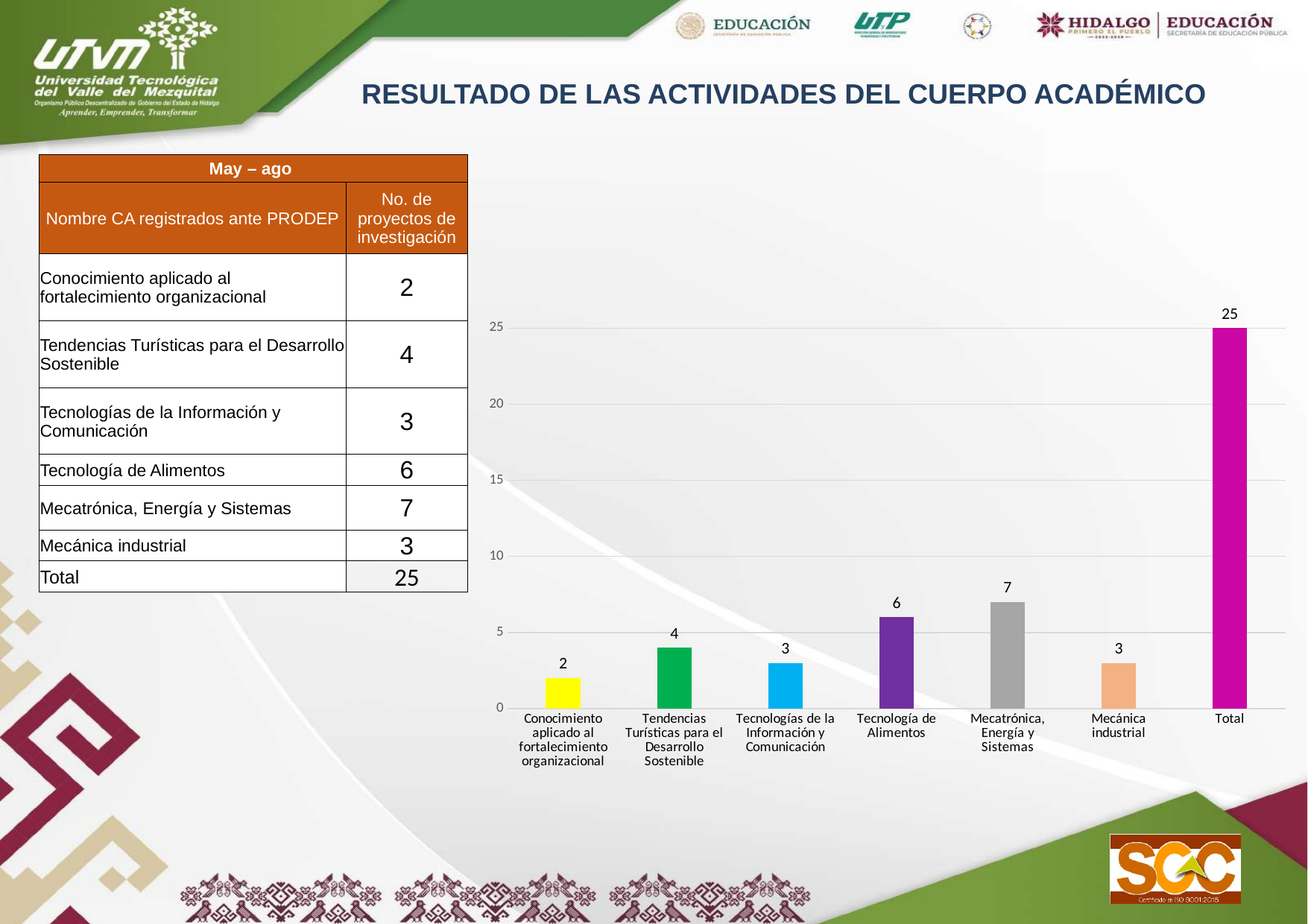
What colour is the Total bar in the chart? Magenta What type of chart is shown on the slide? Bar chart What is the difference between the values for Mecatrónica, Energía y Sistemas and Tendencias Turísticas para el Desarrollo Sostenible? 3 What is the value for Mecatrónica, Energía y Sistemas in the bar chart? 7 Excluding the Total bar, which category has the highest value in the chart? Mecatrónica, Energía y Sistemas What is the value of the Total bar in the chart? 25 Is the value for Tecnología de Alimentos greater or less than 5? greater Which category has the lowest value in the bar chart? Conocimiento aplicado al fortalecimiento organizacional Which is larger in the chart: Tecnología de Alimentos or Mecánica industrial? Tecnología de Alimentos How many bars are shown in the chart, including the Total bar? 7 What is the value for Tecnología de Alimentos in the bar chart? 6 What is the value for Tecnologías de la Información y Comunicación in the chart? 3